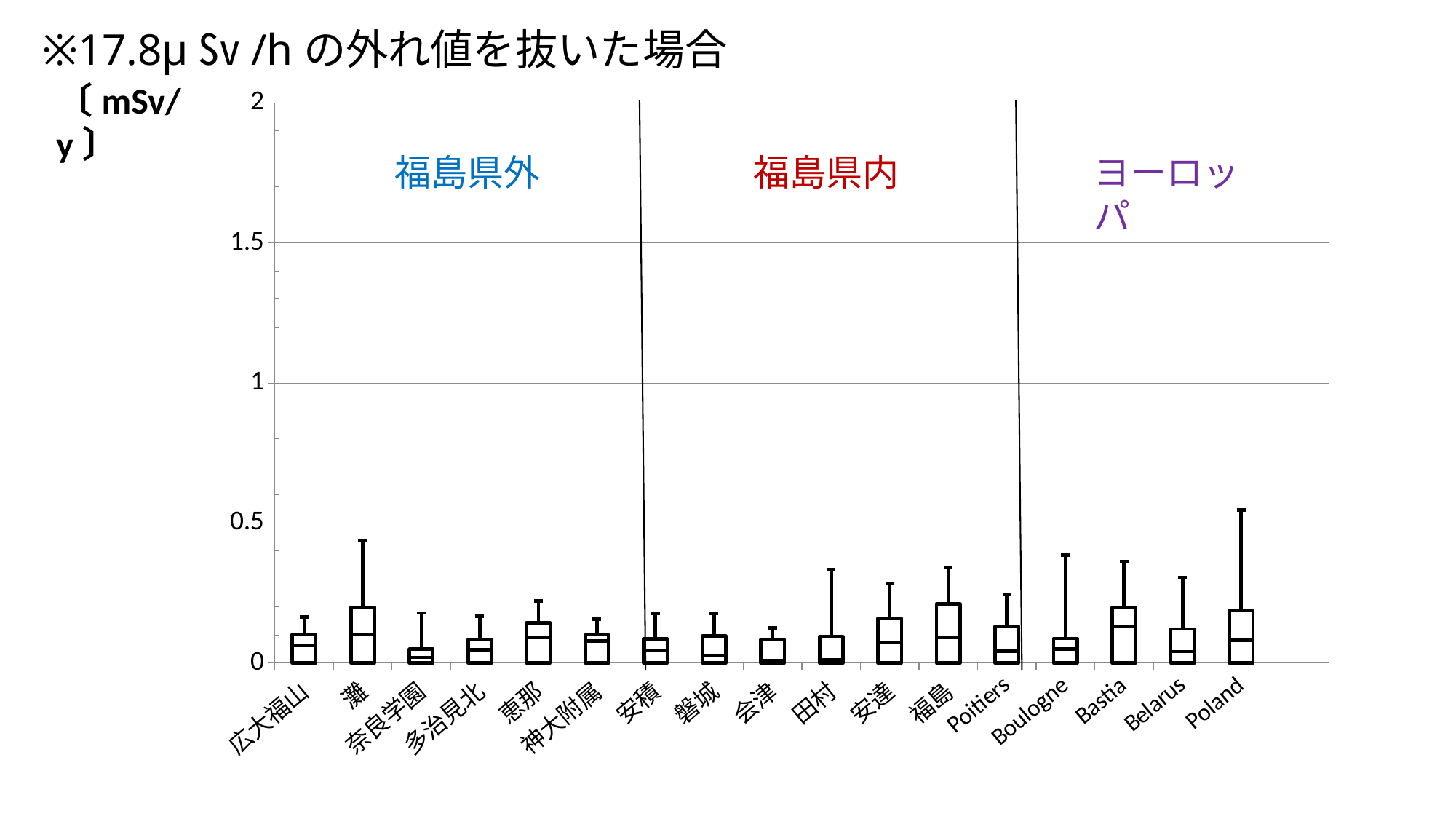
Which has the higher upper whisker, 灘 or 会津? 灘 What kind of chart is shown on the slide? box plot How many categories are shown along the x axis of the chart? 17 Is the upper whisker for Poland greater or less than 0.5? greater What is the maximum value shown on the y axis of the chart? 2 Is the upper whisker for 会津 greater or less than 0.5? less Which has the higher upper whisker, Poland or 灘? Poland What unit is shown on the y axis of the chart? mSv/y Is the upper whisker for 田村 greater or less than 0.5? less Which category has the highest upper whisker in the chart? Poland